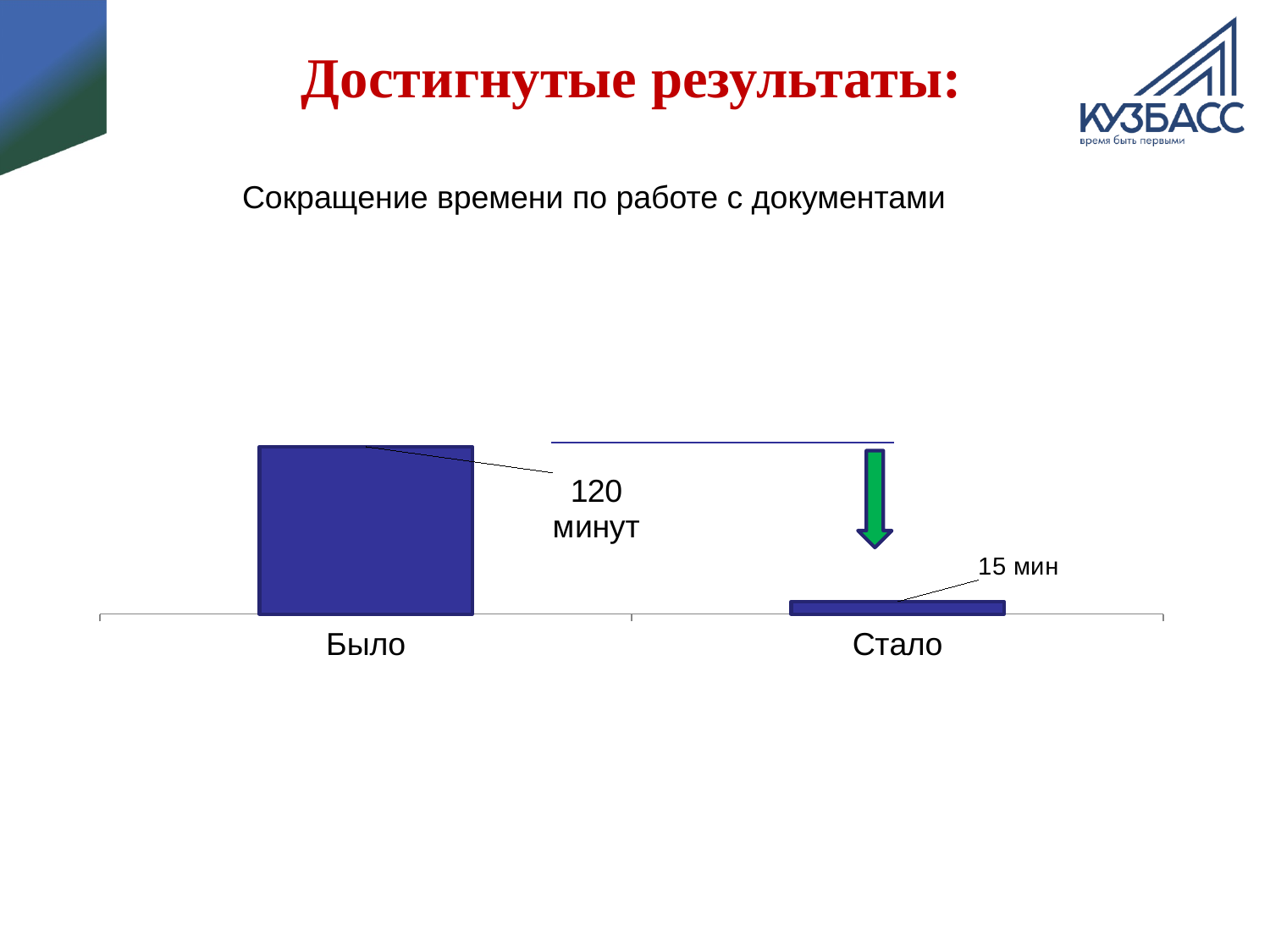
Do the values rise or fall from "Было" to "Стало"? Fall What value is shown for the "Стало" bar? 15 мин What colour are the bars in the chart? Blue Which category has the lowest value? Стало What kind of chart is shown on the slide? Bar chart Which is larger, the value for "Было" or the value for "Стало"? Было How many categories are shown on the x axis? 2 Which category has the highest value? Было By how many minutes does the "Было" value exceed the "Стало" value? 105 минут What value is shown for the "Было" bar? 120 минут What is the title of the chart? Сокращение времени по работе с документами